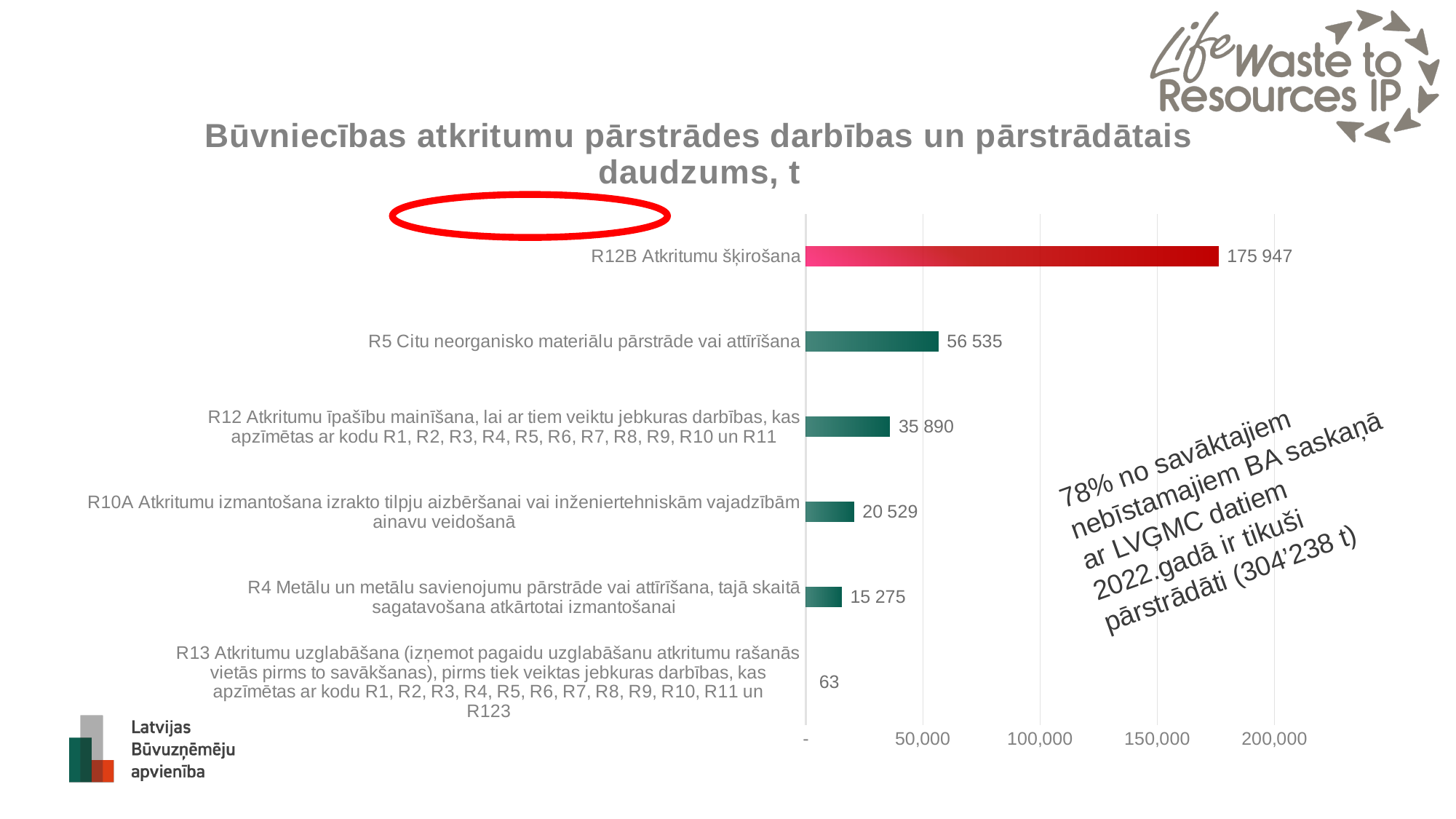
Which is larger, the value for R12 Atkritumu īpašību mainīšana or the value for R10A Atkritumu izmantošana izrakto tilpju aizbēršanai? R12 Atkritumu īpašību mainīšana What is the value for R4 Metālu un metālu savienojumu pārstrāde vai attīrīšana? 15 275 What is the value for R10A Atkritumu izmantošana izrakto tilpju aizbēršanai vai inženiertehniskām vajadzībām ainavu veidošanā? 20 529 What is the value for R5 Citu neorganisko materiālu pārstrāde vai attīrīšana? 56 535 What kind of chart is shown on the slide? bar chart How many categories are shown in the chart? 6 Is the value for R5 Citu neorganisko materiālu pārstrāde vai attīrīšana greater or less than 50,000? greater What is the value for R12B Atkritumu šķirošana? 175 947 Which category has the lowest value? R13 Atkritumu uzglabāšana What is the difference between the values for R12B Atkritumu šķirošana and R5 Citu neorganisko materiālu pārstrāde vai attīrīšana? 119 412 What is the title of the chart? Būvniecības atkritumu pārstrādes darbības un pārstrādātais daudzums, t Which category has the highest value? R12B Atkritumu šķirošana